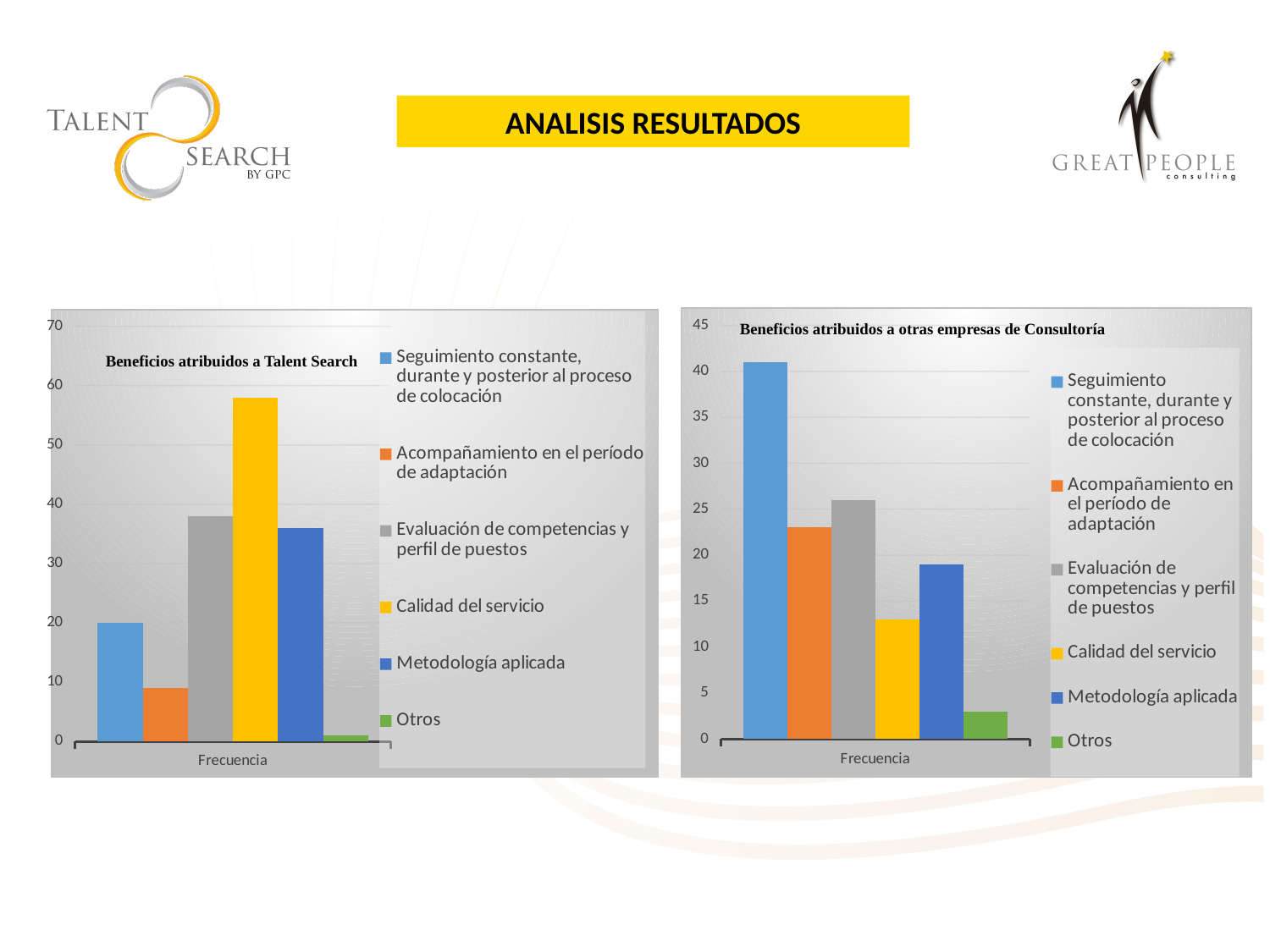
What is the x-axis category label shown in the chart titled 'Beneficios atribuidos a otras empresas de Consultoría'? Frecuencia In the chart titled 'Beneficios atribuidos a Talent Search', is the value for 'Calidad del servicio' greater or less than 50? greater In the chart titled 'Beneficios atribuidos a Talent Search', which series has the highest value? Calidad del servicio In the chart titled 'Beneficios atribuidos a Talent Search', what kind of chart is shown? bar chart In the chart titled 'Beneficios atribuidos a otras empresas de Consultoría', which series has the lowest value? Otros In the chart titled 'Beneficios atribuidos a Talent Search', how many series does the legend list? 6 In the chart titled 'Beneficios atribuidos a otras empresas de Consultoría', which series has the highest value? Seguimiento constante, durante y posterior al proceso de colocación In the chart titled 'Beneficios atribuidos a otras empresas de Consultoría', which is larger: 'Metodología aplicada' or 'Calidad del servicio'? Metodología aplicada In the chart titled 'Beneficios atribuidos a Talent Search', which series has the lowest value? Otros In the chart titled 'Beneficios atribuidos a Talent Search', which is larger: 'Seguimiento constante, durante y posterior al proceso de colocación' or 'Metodología aplicada'? Metodología aplicada